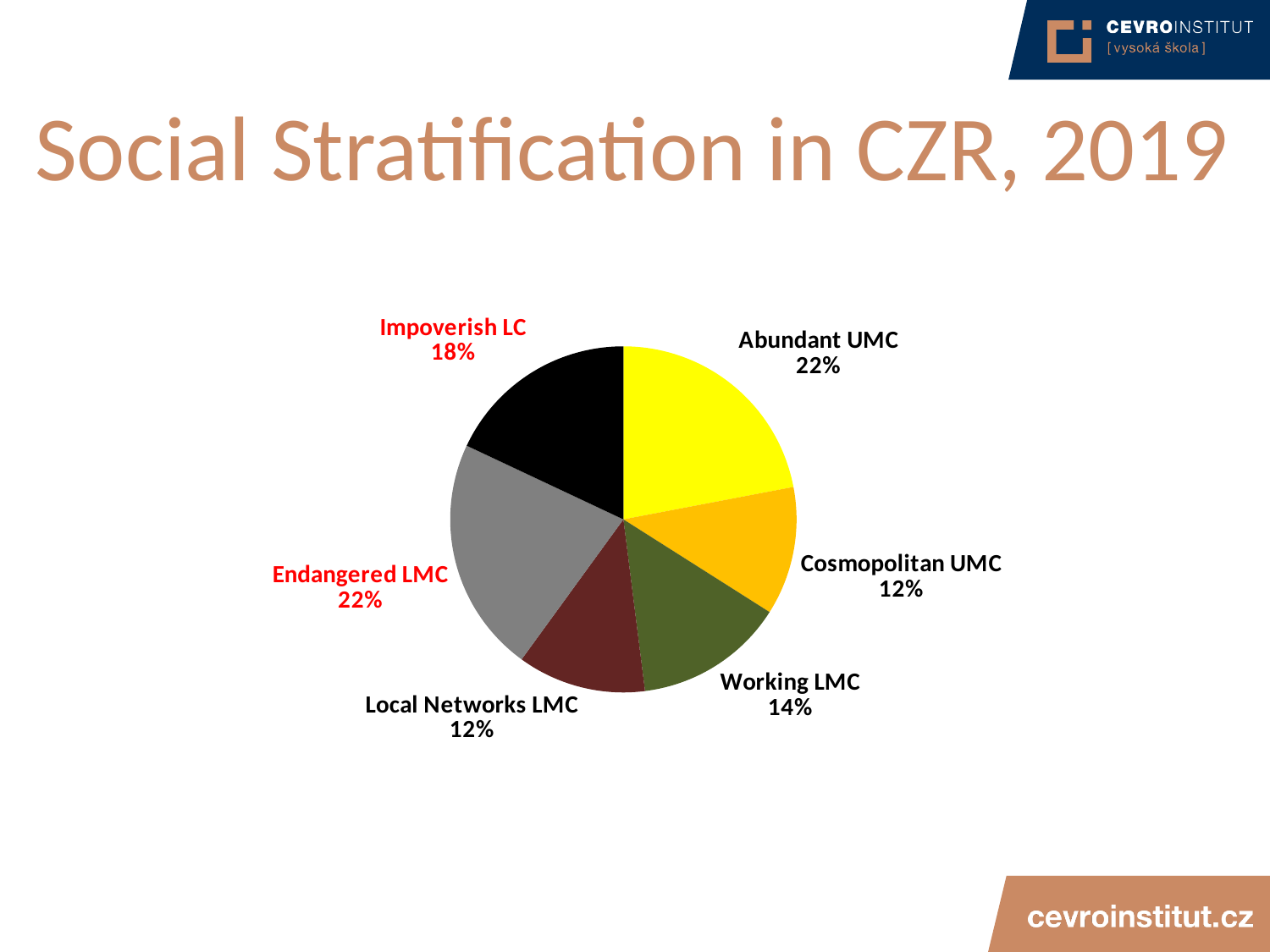
What share of the pie does Abundant UMC hold? 22% What is the value for Local Networks LMC? 12% What is the difference in percentage points between Abundant UMC and Working LMC? 8 percentage points What is the value shown for Cosmopolitan UMC? 12% What share is shown for Endangered LMC? 22% How many slices does the pie chart have? 6 What colour is the Abundant UMC slice? Yellow Which is larger, the share for Impoverish LC or the share for Working LMC? Impoverish LC What kind of chart is shown on the slide? Pie chart Which is larger, Abundant UMC or Cosmopolitan UMC? Abundant UMC What is the value for Impoverish LC? 18% What percentage is labelled for Working LMC? 14%